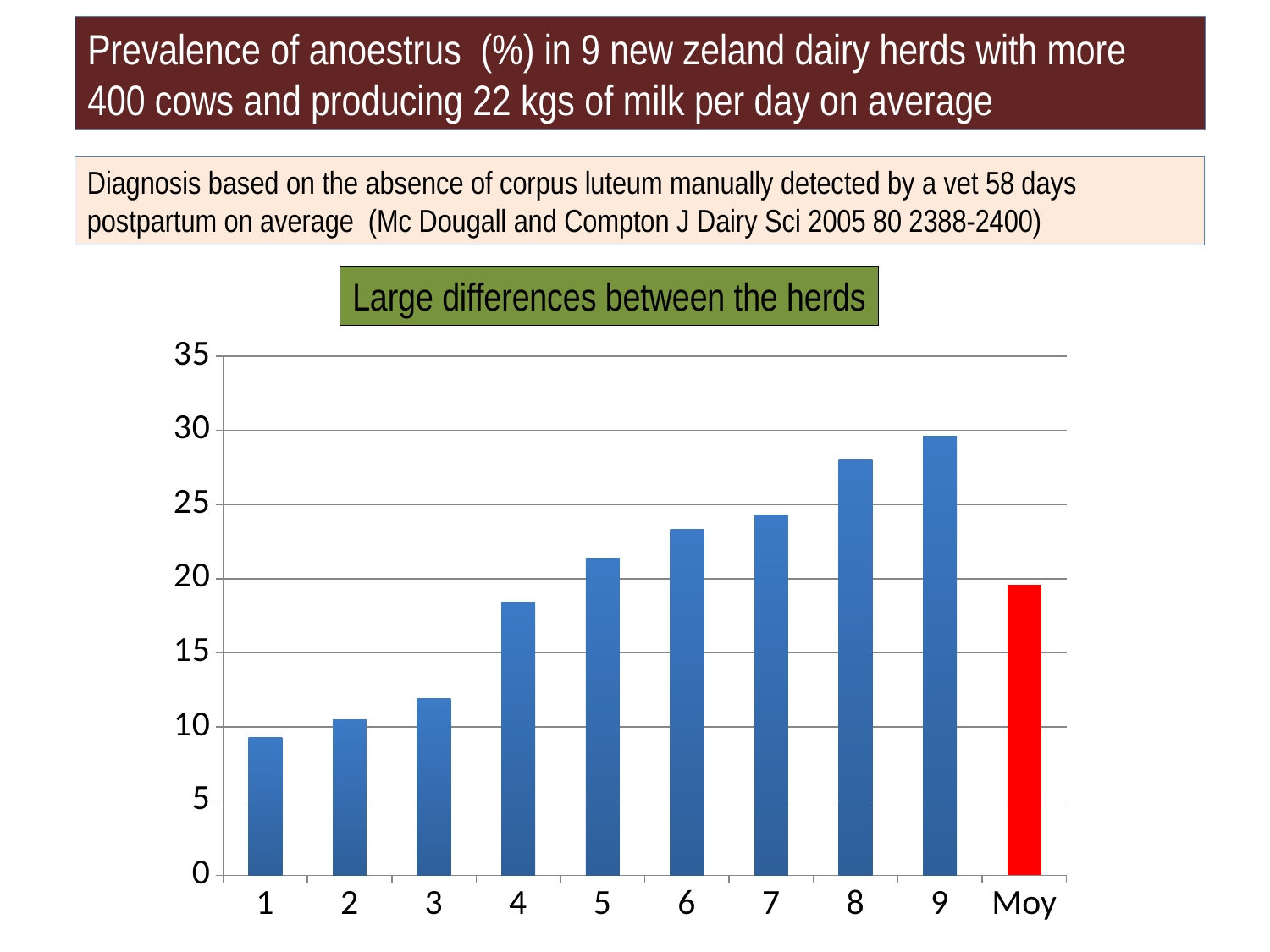
Is the value for herd 6 greater or less than 25? less What kind of chart is shown on the slide? bar chart Do the values rise or fall from herd 1 to herd 9? rise Which herd has the lowest prevalence of anoestrus? 1 What colour is the bar for Moy? red How many bars are plotted on the chart? 10 Which herd has the highest prevalence of anoestrus? 9 Is the value for herd 4 greater or less than 20? less Which is larger, the value for herd 8 or the value for herd 4? herd 8 Is the value for herd 8 greater or less than 25? greater